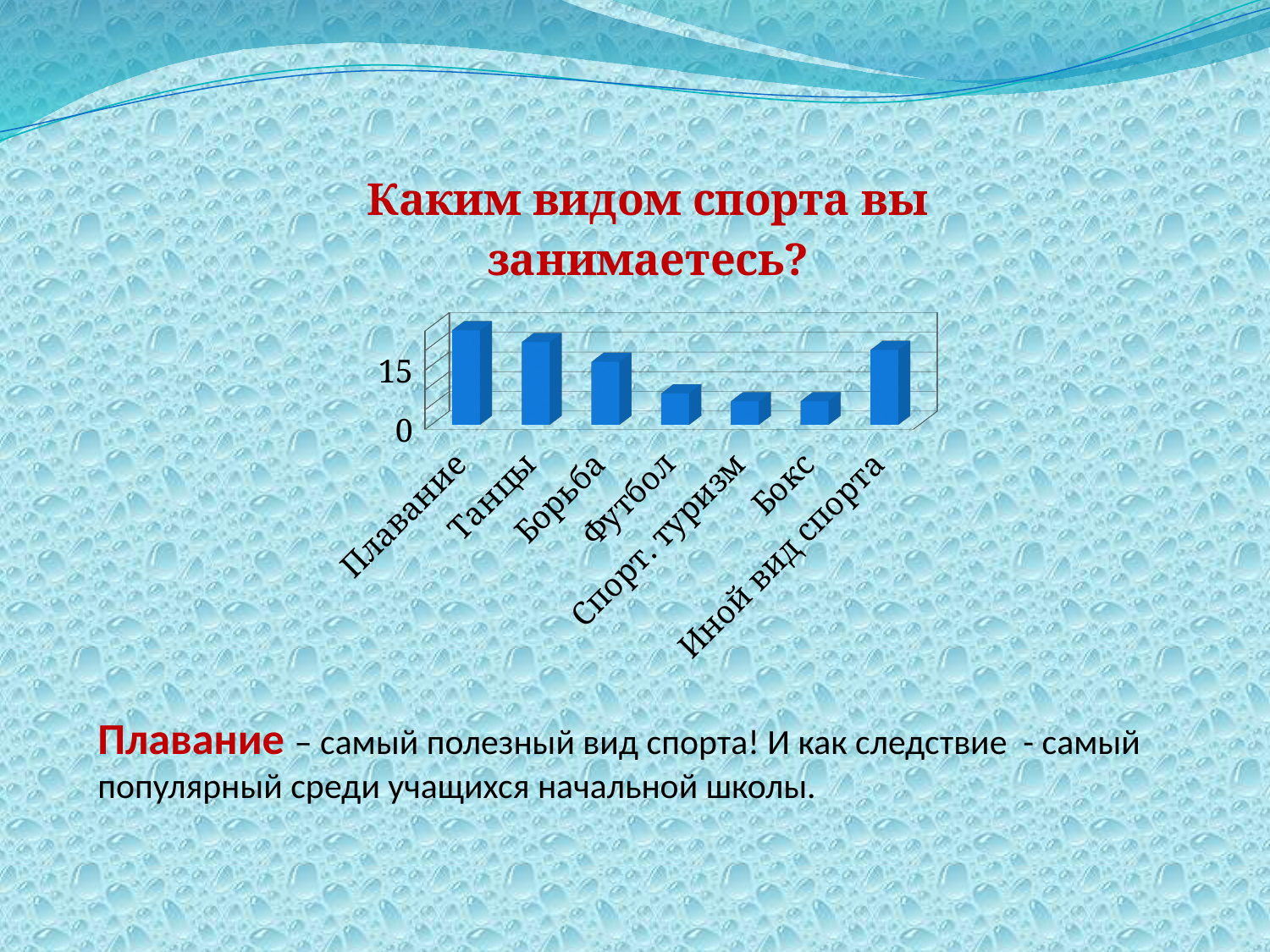
Is the value for Иной вид спорта greater or less than 15? greater What kind of chart is shown on the slide? Bar chart Which category has the highest bar in the chart? Плавание Is the value for Спорт. туризм greater or less than 15? less Is the value for Танцы greater or less than 15? greater How many categories (sports) are shown on the x axis of the chart? 7 What is the title of the chart on the slide? Каким видом спорта вы занимаетесь? Which is larger, the value for Танцы or the value for Бокс? Танцы Which is larger, the value for Плавание or the value for Футбол? Плавание